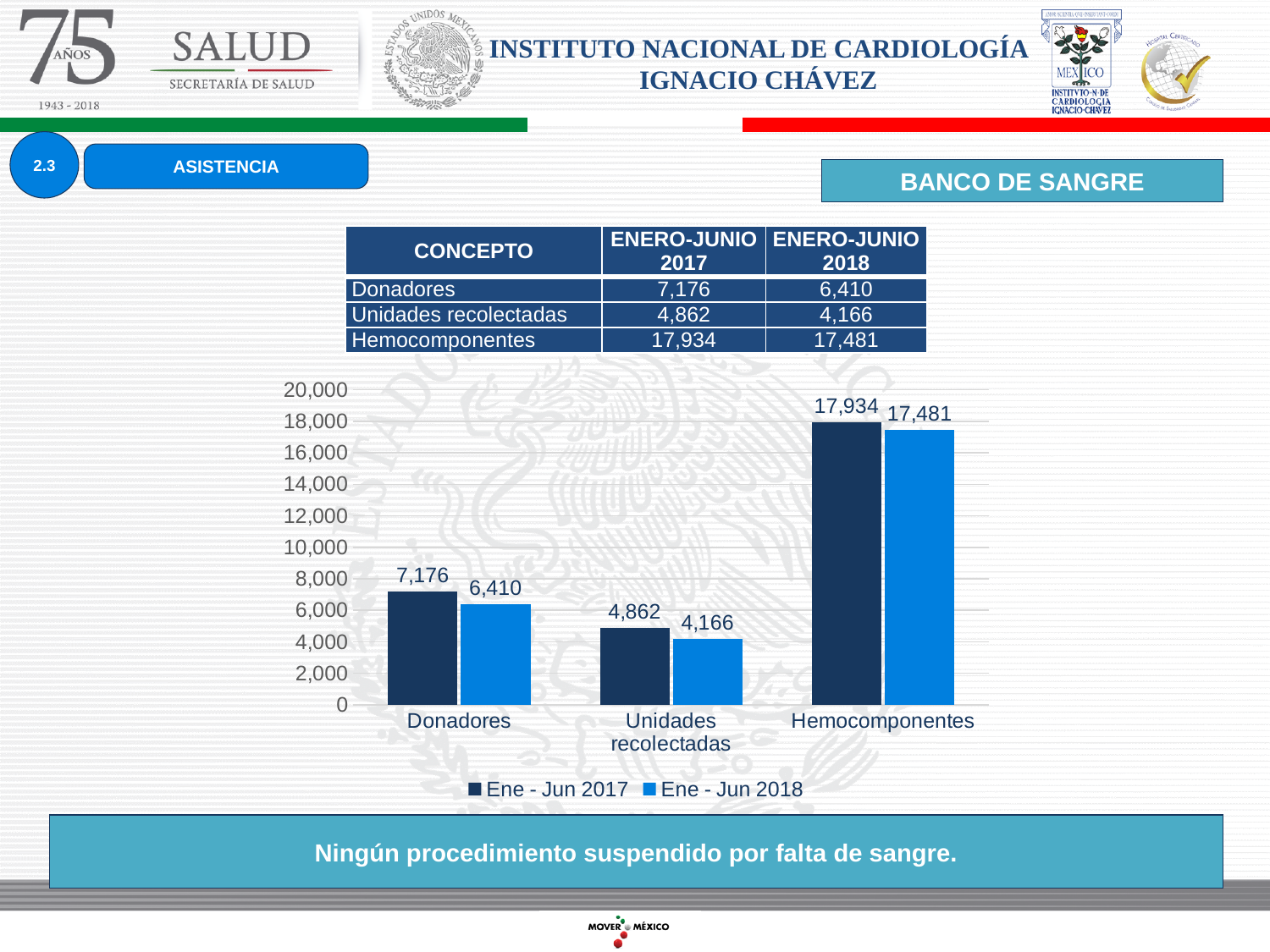
What is the value for Hemocomponentes in the Ene - Jun 2018 series? 17,481 What is the value for Unidades recolectadas in the Ene - Jun 2018 series? 4,166 How many categories are shown on the x axis of the chart? 3 What is the value for Donadores in the Ene - Jun 2017 series? 7,176 Which category has the lowest value in the Ene - Jun 2018 series? Unidades recolectadas Is the Ene - Jun 2018 value for Hemocomponentes greater or less than 16,000? greater What kind of chart is shown on the slide? Bar chart What is the difference between the Ene - Jun 2017 and Ene - Jun 2018 values for Hemocomponentes? 453 What is the difference between the Ene - Jun 2017 and Ene - Jun 2018 values for Donadores? 766 How many series does the chart legend list? 2 Which is larger for Unidades recolectadas: the Ene - Jun 2017 value or the Ene - Jun 2018 value? Ene - Jun 2017 Which category has the highest value in the Ene - Jun 2017 series? Hemocomponentes